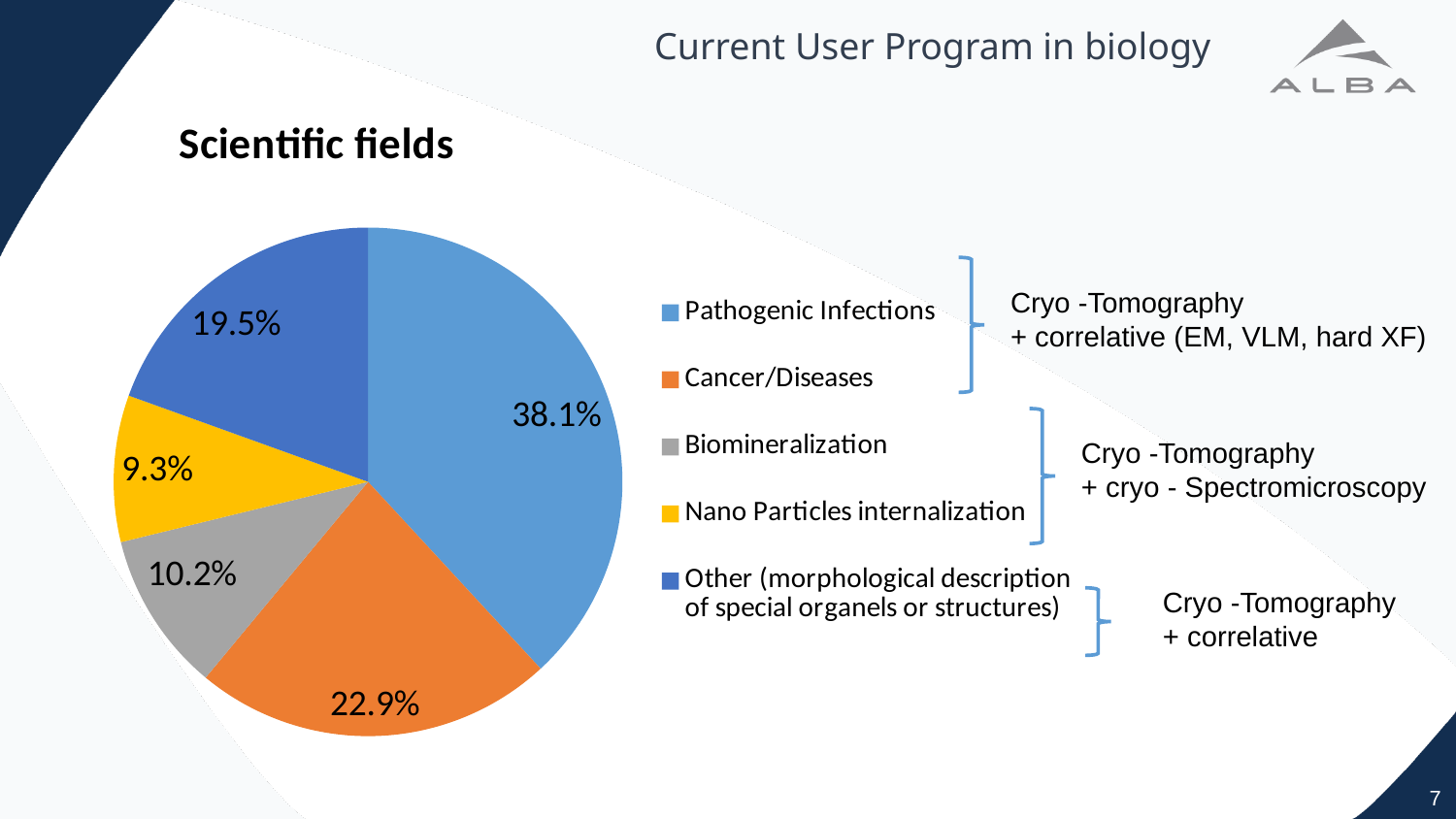
What colour is the Cancer/Diseases slice in the pie chart? Orange Which scientific field has the largest share of the pie? Pathogenic Infections What share of the pie does Biomineralization have? 10.2% What share of the pie does the Other (morphological description of special organels or structures) slice have? 19.5% What share of the pie does Cancer/Diseases have? 22.9% What is the difference in percentage points between Pathogenic Infections and Cancer/Diseases? 15.2 What share of the pie does Nano Particles internalization have? 9.3% What share of the pie does Pathogenic Infections have? 38.1% How many slices does the pie chart have? 5 Which is larger, the share for Biomineralization or the share for Other (morphological description of special organels or structures)? Other (morphological description of special organels or structures) What kind of chart is shown on the slide? Pie chart Which scientific field has the smallest share of the pie? Nano Particles internalization